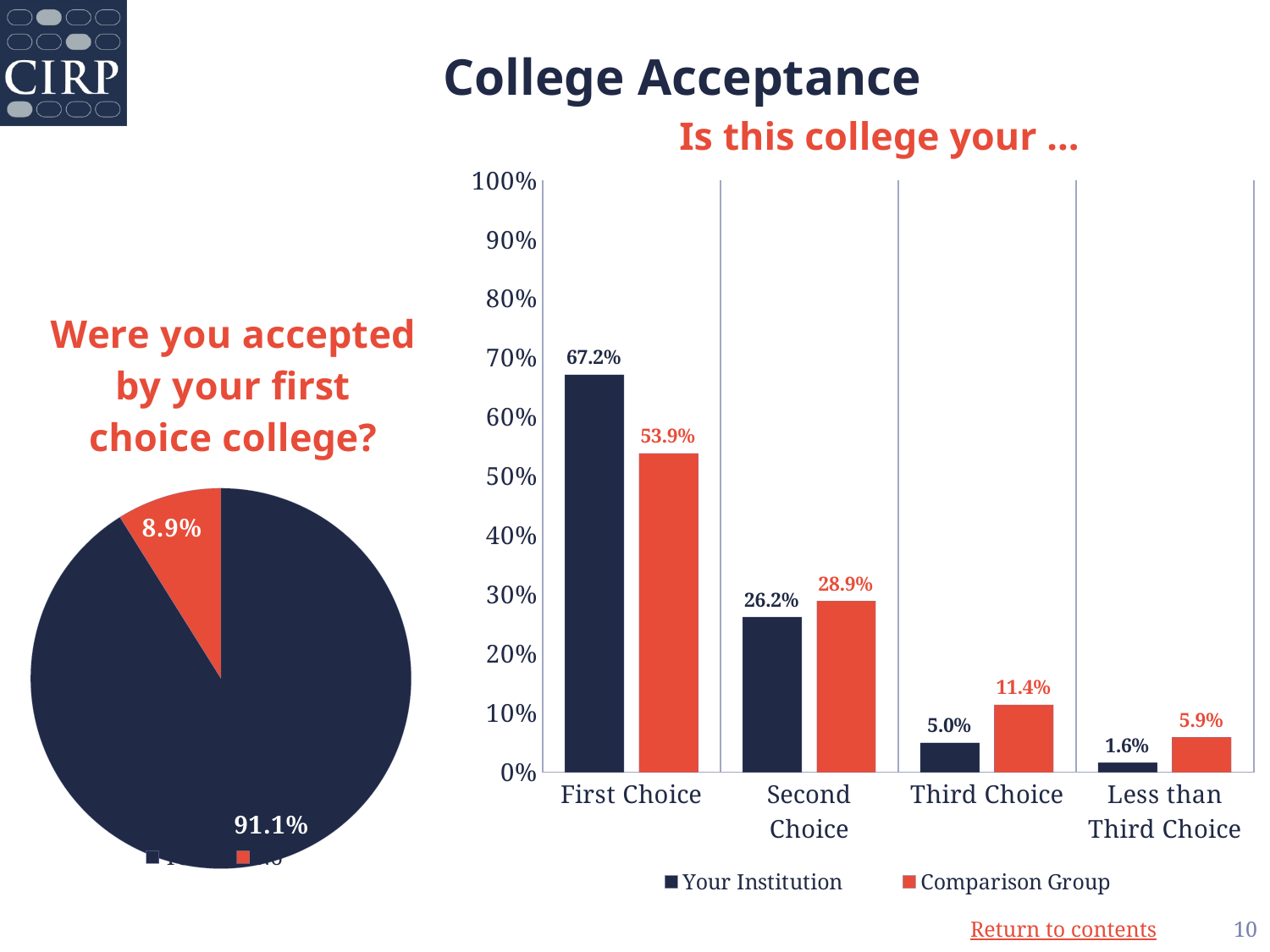
In the 'Is this college your ...' chart, what is the value for Comparison Group for Second Choice? 28.9% In the 'Were you accepted by your first choice college?' pie chart, what share does the orange slice represent? 8.9% In the 'Is this college your ...' chart, what is the value for Your Institution for First Choice? 67.2% In the 'Is this college your ...' chart, how many series does the legend list? 2 In the 'Is this college your ...' chart, which category has the highest value for Comparison Group? First Choice In the 'Is this college your ...' chart, what is the difference between Your Institution and Comparison Group for First Choice? 13.3% What kind of chart is the 'Were you accepted by your first choice college?' chart? pie chart In the 'Is this college your ...' chart, what is the value for Comparison Group for Less than Third Choice? 5.9% In the 'Is this college your ...' chart, which category has the lowest value for Your Institution? Less than Third Choice In the 'Is this college your ...' chart, how many categories are shown on the x axis? 4 In the 'Is this college your ...' chart, do the values for Your Institution rise or fall from First Choice to Less than Third Choice? fall In the 'Is this college your ...' chart, which is larger for Third Choice: Your Institution or Comparison Group? Comparison Group